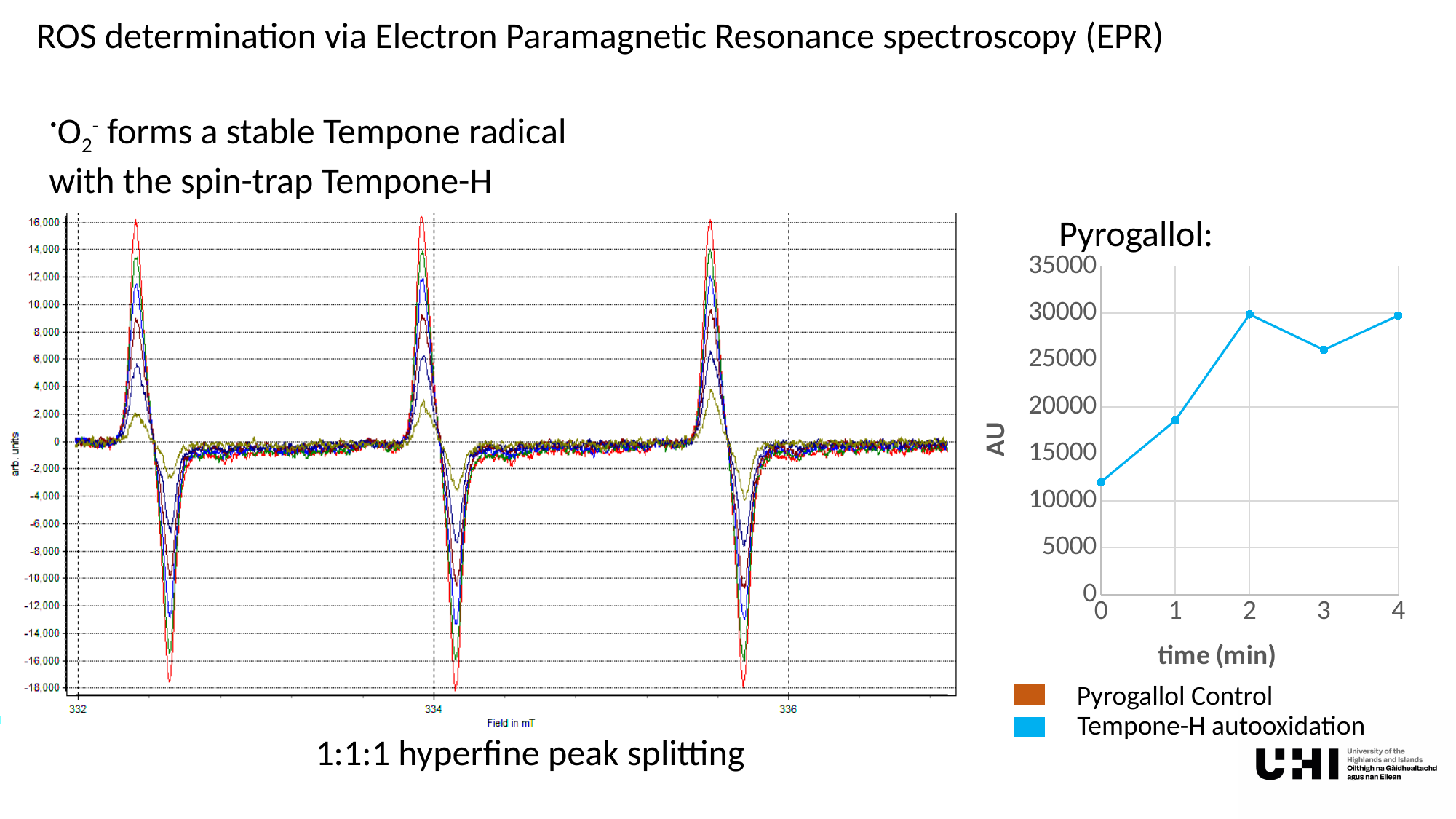
In the Pyrogallol chart, is the value at 0 min greater or less than 15000? less In the Pyrogallol chart, how many data points are plotted on the line? 5 In the Pyrogallol chart, does the value rise or fall between 0 min and 2 min? rise What type of chart is the Pyrogallol chart on the right of the slide? line chart In the Pyrogallol chart, how many entries does the legend list? 2 In the Pyrogallol chart, is the value at 3 min greater or less than 30000? less In the Pyrogallol chart, is the value at 2 min greater or less than 25000? greater In the Pyrogallol chart, at which time is the value lowest? 0 min In the EPR spectrum chart on the left, what is the label of the x axis? Field in mT In the Pyrogallol chart, what is the label of the x axis? time (min) In the Pyrogallol chart, which is larger, the value at 1 min or the value at 3 min? 3 min